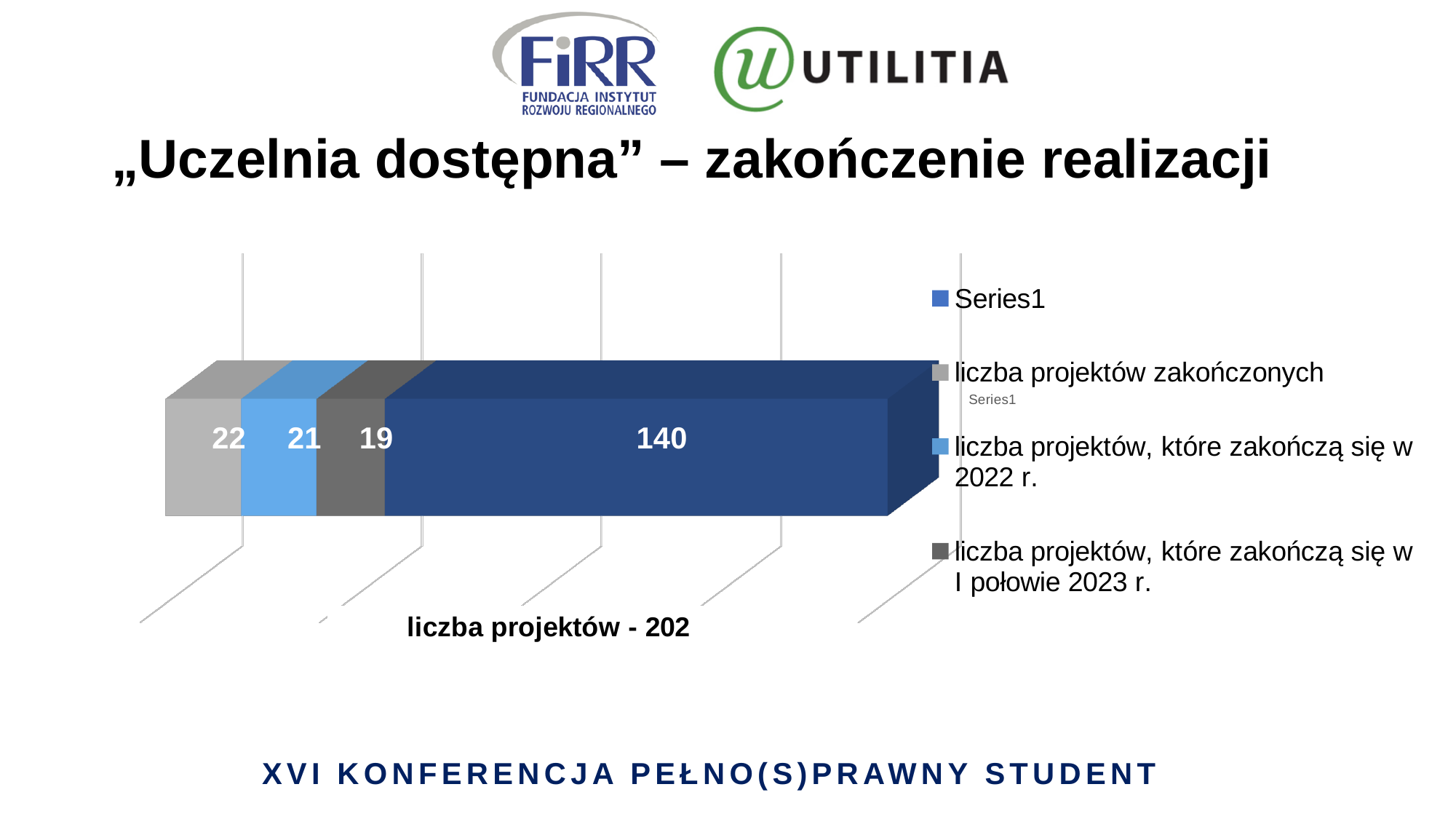
What is the difference between the "Series1" segment and the "liczba projektów zakończonych" segment? 118 What is the value of the segment labelled "Series1" in the legend? 140 What is the value of the segment for "liczba projektów, które zakończą się w 2022 r."? 21 How many entries does the legend list? 4 What is the value of the segment for "liczba projektów, które zakończą się w I połowie 2023 r."? 19 Which is larger: the segment for projects ending in 2022 or the segment for projects ending in the first half of 2023? projects ending in 2022 (21) What is the value of the segment labelled "liczba projektów zakończonych"? 22 What is the total of all segments in the stacked bar? 202 What kind of chart is shown on the slide? stacked bar chart Which segment of the bar has the largest value? Series1 Which segment of the bar has the smallest value? liczba projektów, które zakończą się w I połowie 2023 r. What is the label printed below the bar? liczba projektów - 202